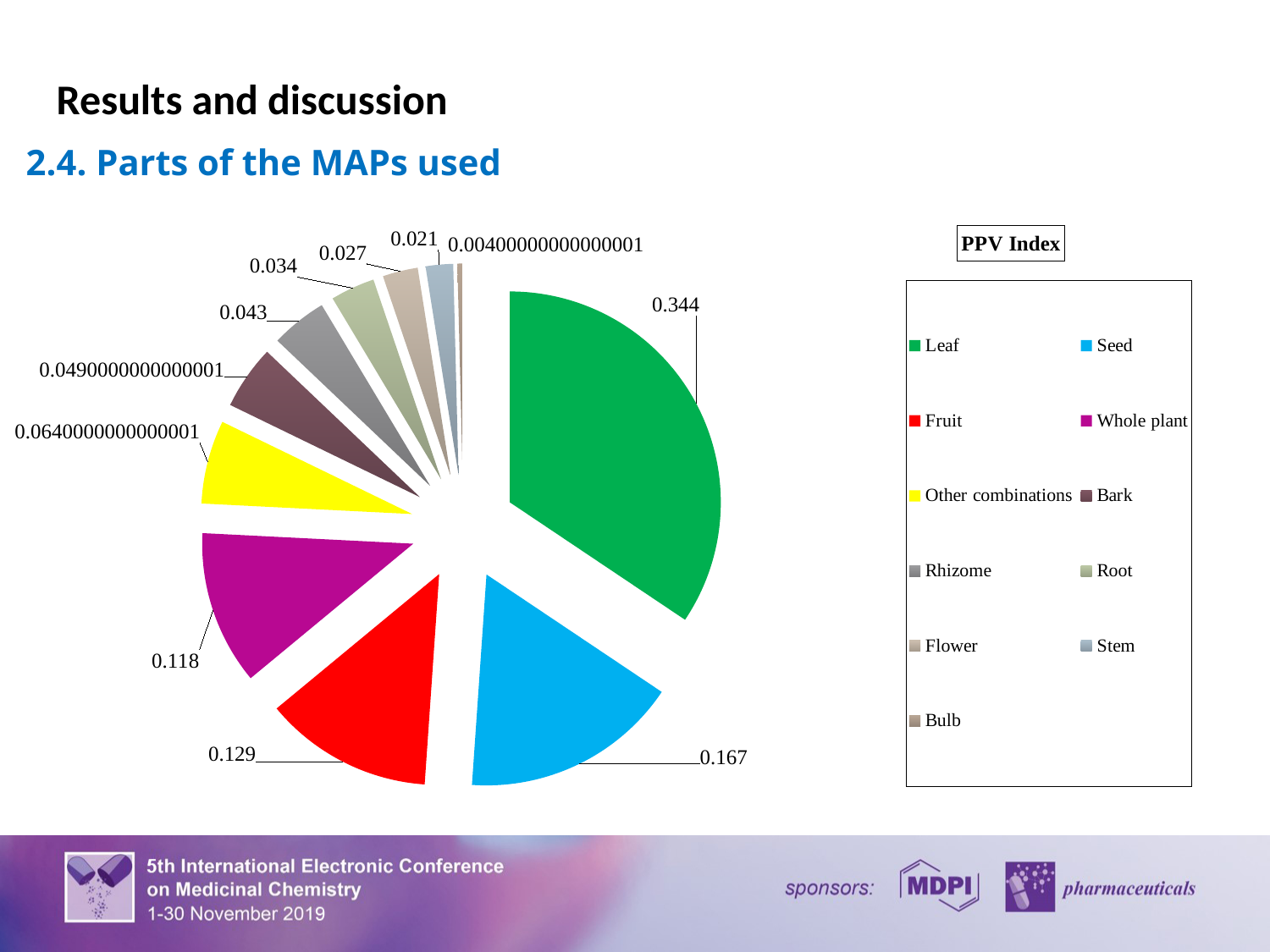
What is the value shown for Fruit in the pie chart? 0.129 Which has a larger value, Seed or Fruit? Seed Which plant part has the smallest slice in the pie chart? Bulb What type of chart is shown on the slide? Pie chart What is the title of the chart? PPV Index What is the value shown for Whole plant in the pie chart? 0.118 What is the difference between the values for Leaf and Seed? 0.177 How many categories does the pie chart show? 11 Which plant part has the largest slice in the pie chart? Leaf What is the value shown for Leaf in the pie chart? 0.344 What is the value shown for Seed in the pie chart? 0.167 What is the value shown for Rhizome in the pie chart? 0.043